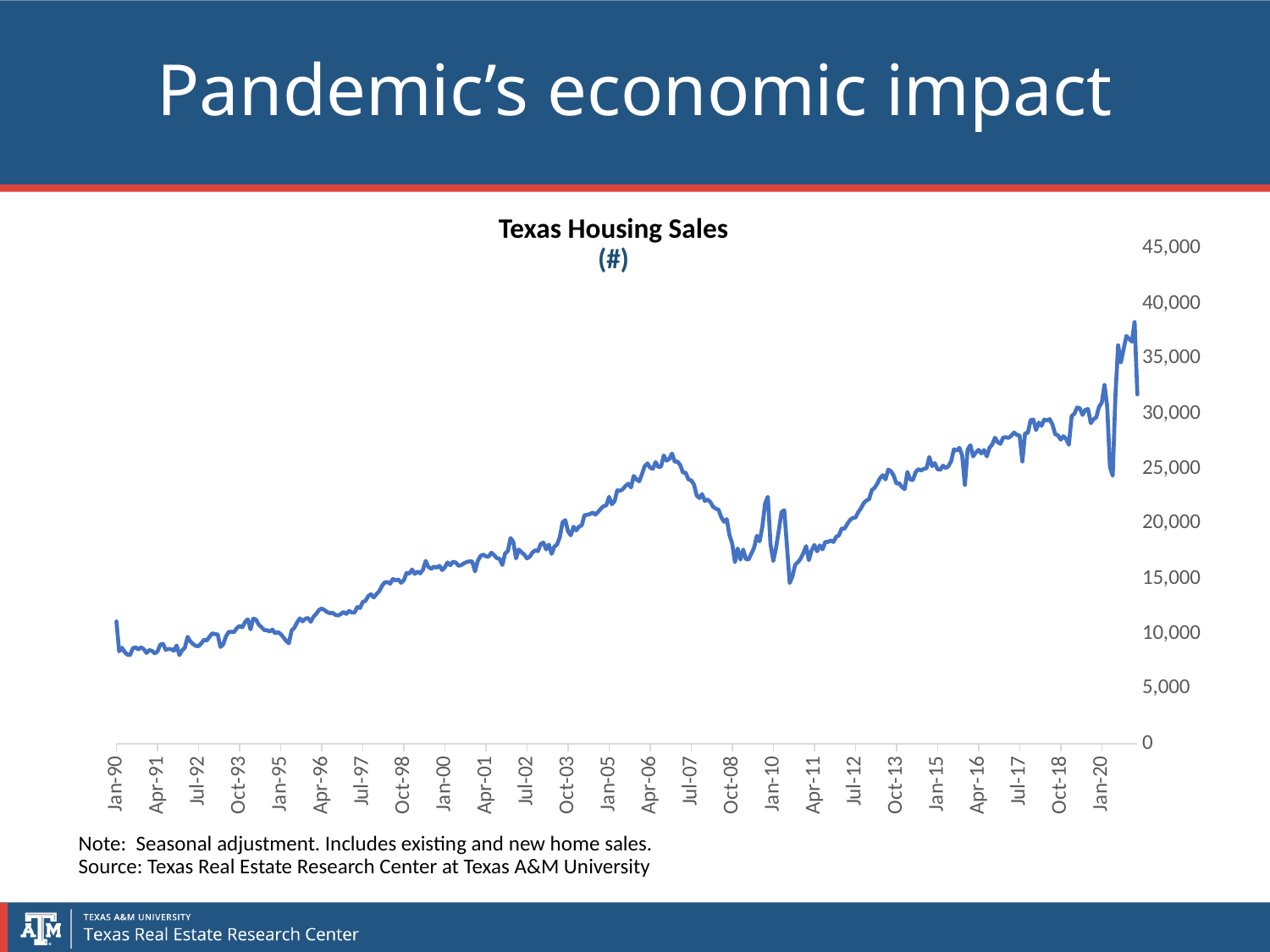
Is the value for Jul-17 greater or less than 25,000? greater Is the value for Jan-20 greater or less than 25,000? greater What is the highest value shown on the vertical axis? 45,000 Is the highest point on the line greater or less than 35,000? greater Which is larger, the value for Jul-07 or the value for Jul-17? Jul-17 What is the title of the chart? Texas Housing Sales (#) Between Apr-06 and Oct-08, does the line rise or fall? Fall Overall, do Texas housing sales rise or fall from Jan-90 to the end of the series? Rise What kind of chart is shown on the slide? Line chart Which is larger, the value for Jan-20 or the value for Jan-90? Jan-20